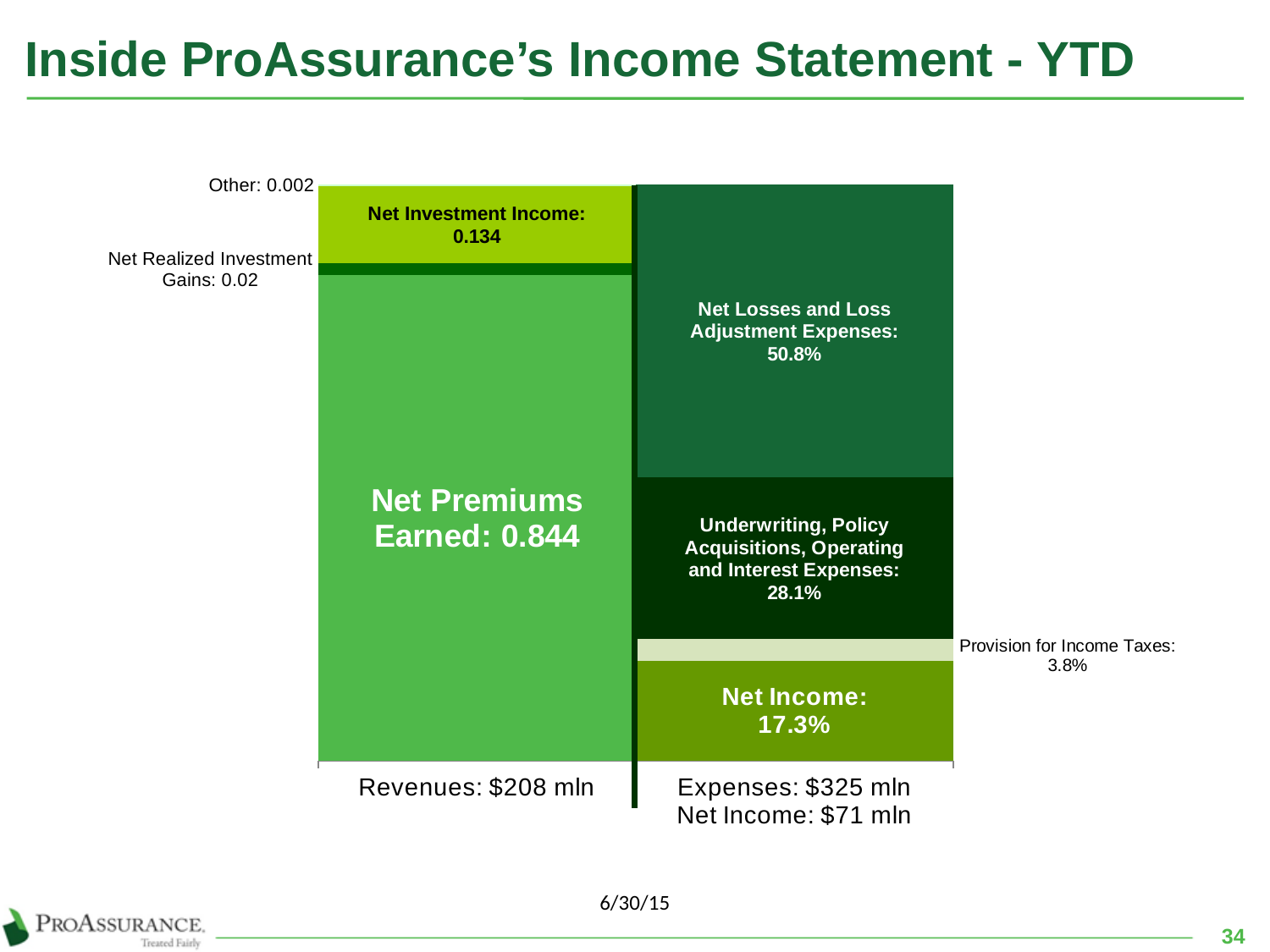
What is the value for Net Realized Investment Gains in the Revenues bar? 0.02 Which is larger in the Revenues bar: Net Investment Income or Net Realized Investment Gains? Net Investment Income What share of the Expenses bar is Net Losses and Loss Adjustment Expenses? 50.8% What is the difference between Net Losses and Loss Adjustment Expenses (50.8%) and Underwriting, Policy Acquisitions, Operating and Interest Expenses (28.1%)? 22.7% Which segment of the Revenues bar is the smallest? Other How many segments make up the Expenses bar? 4 Which segment of the Expenses bar is the largest? Net Losses and Loss Adjustment Expenses What share of the Expenses bar is Net Income? 17.3% What is the value for Net Premiums Earned in the Revenues bar? 0.844 What share of the Expenses bar is Provision for Income Taxes? 3.8% What is the value for Net Investment Income in the Revenues bar? 0.134 What kind of chart is shown on the slide? Stacked bar chart